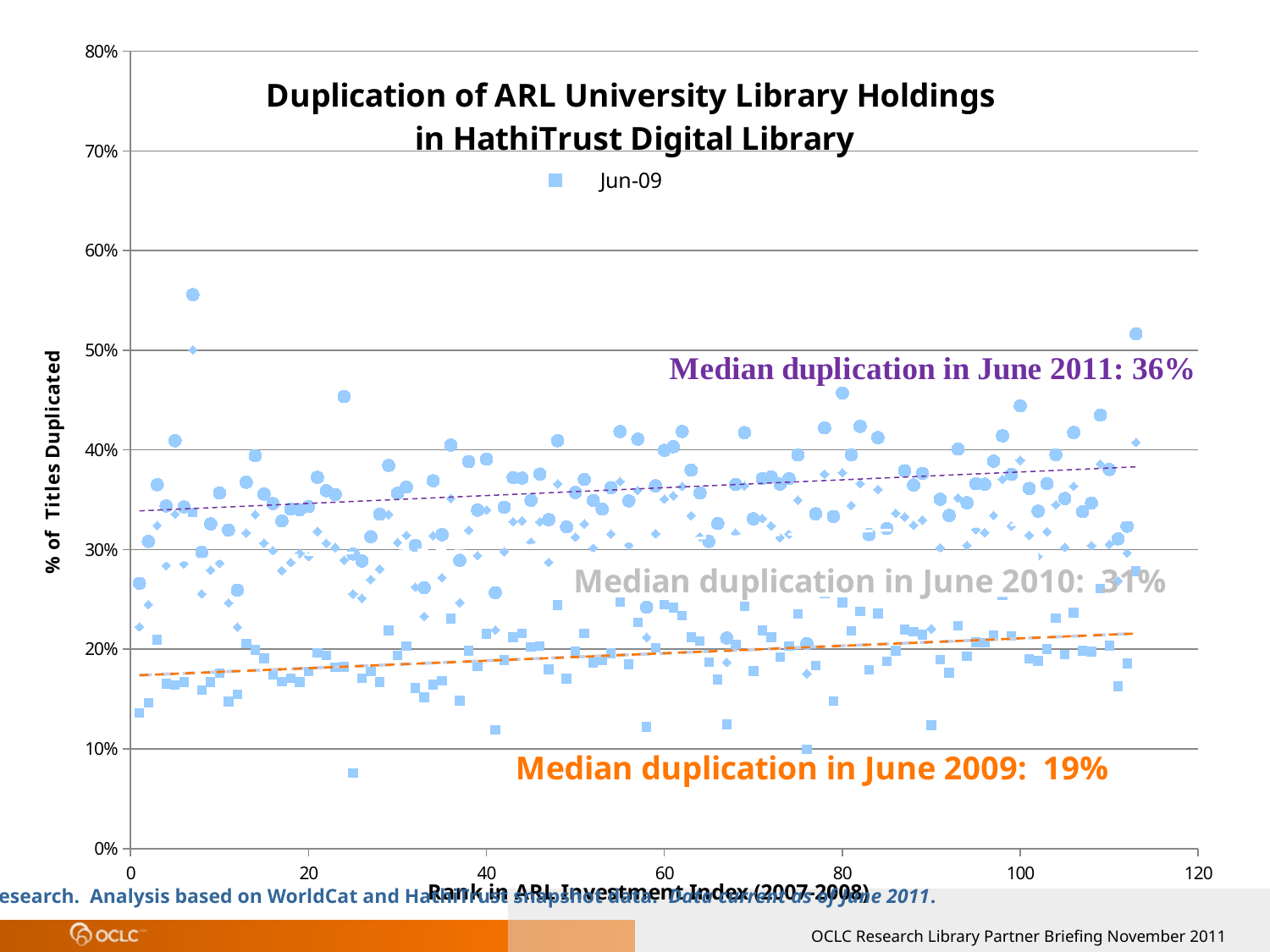
What is the title of the chart? Duplication of ARL University Library Holdings in HathiTrust Digital Library Is the highest plotted point on the chart greater or less than 50%? greater What is the label of the vertical axis? % of Titles Duplicated Do the dashed trend lines rise or fall as the rank in the ARL Investment Index increases? Rise According to the annotation on the chart, what was the median duplication in June 2011? 36% By how many percentage points did the median duplication increase from June 2009 to June 2011? 17 According to the annotation on the chart, what was the median duplication in June 2009? 19% By how many percentage points did the median duplication increase from June 2010 to June 2011? 5 Which of the three annotated years has the lowest median duplication? June 2009 What kind of chart is shown on the slide? Scatter chart Which year had the higher median duplication, June 2009 or June 2010? June 2010 According to the annotation on the chart, what was the median duplication in June 2010? 31%